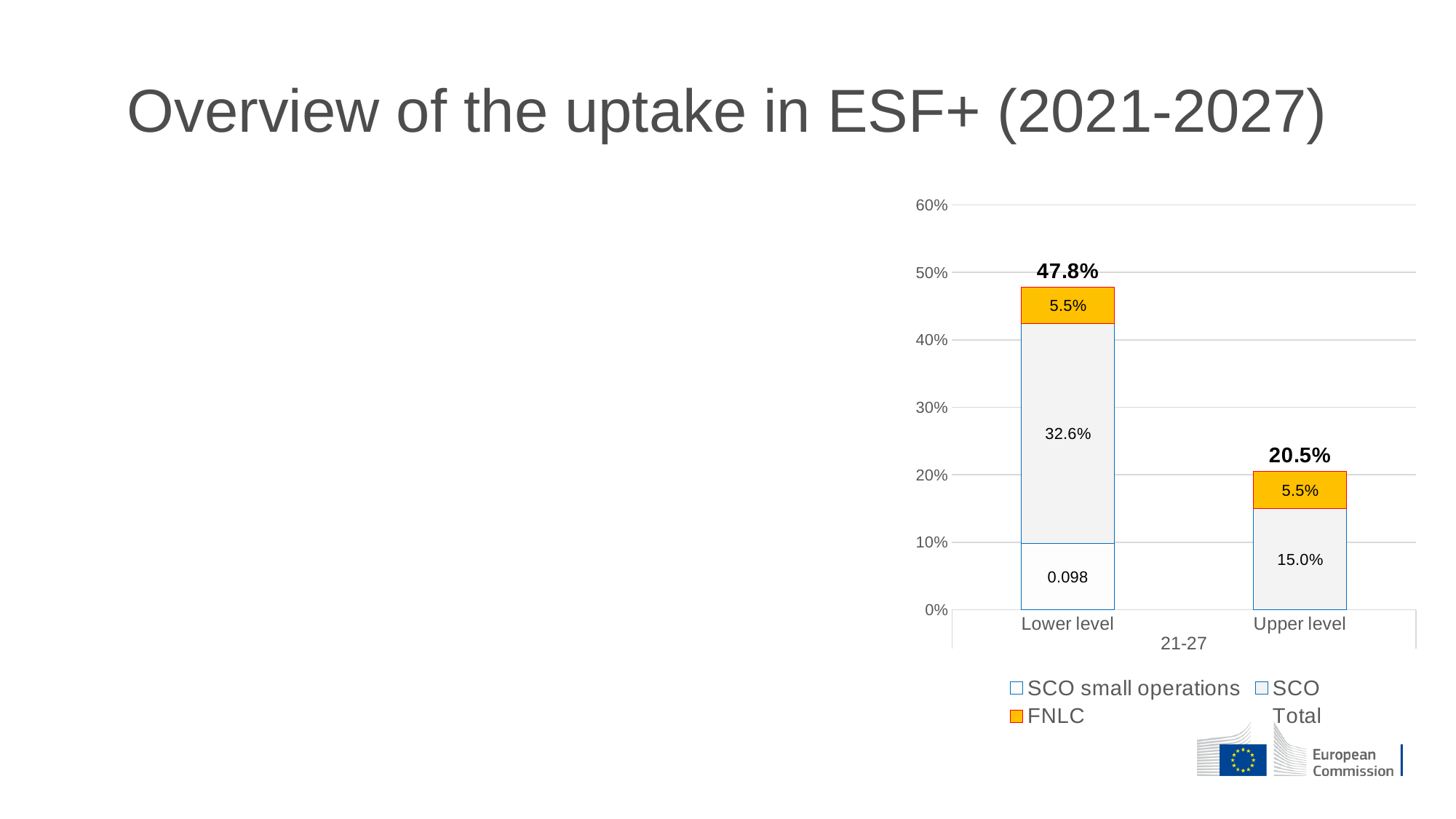
How many entries does the legend list? 4 What is the total value shown above the Upper level bar? 20.5% Which category has the higher total, Lower level or Upper level? Lower level What is the FNLC value for the Upper level bar? 5.5% What is the SCO value for the Lower level bar? 32.6% What is the SCO value for the Upper level bar? 15.0% What is the difference between the SCO values for Lower level and Upper level? 17.6% How many categories are shown on the x axis? 2 What type of chart is shown on the slide? Stacked bar chart What label is printed on the SCO small operations segment of the Lower level bar? 0.098 What is the difference between the Lower level total and the Upper level total? 27.3% What is the total value shown above the Lower level bar? 47.8%